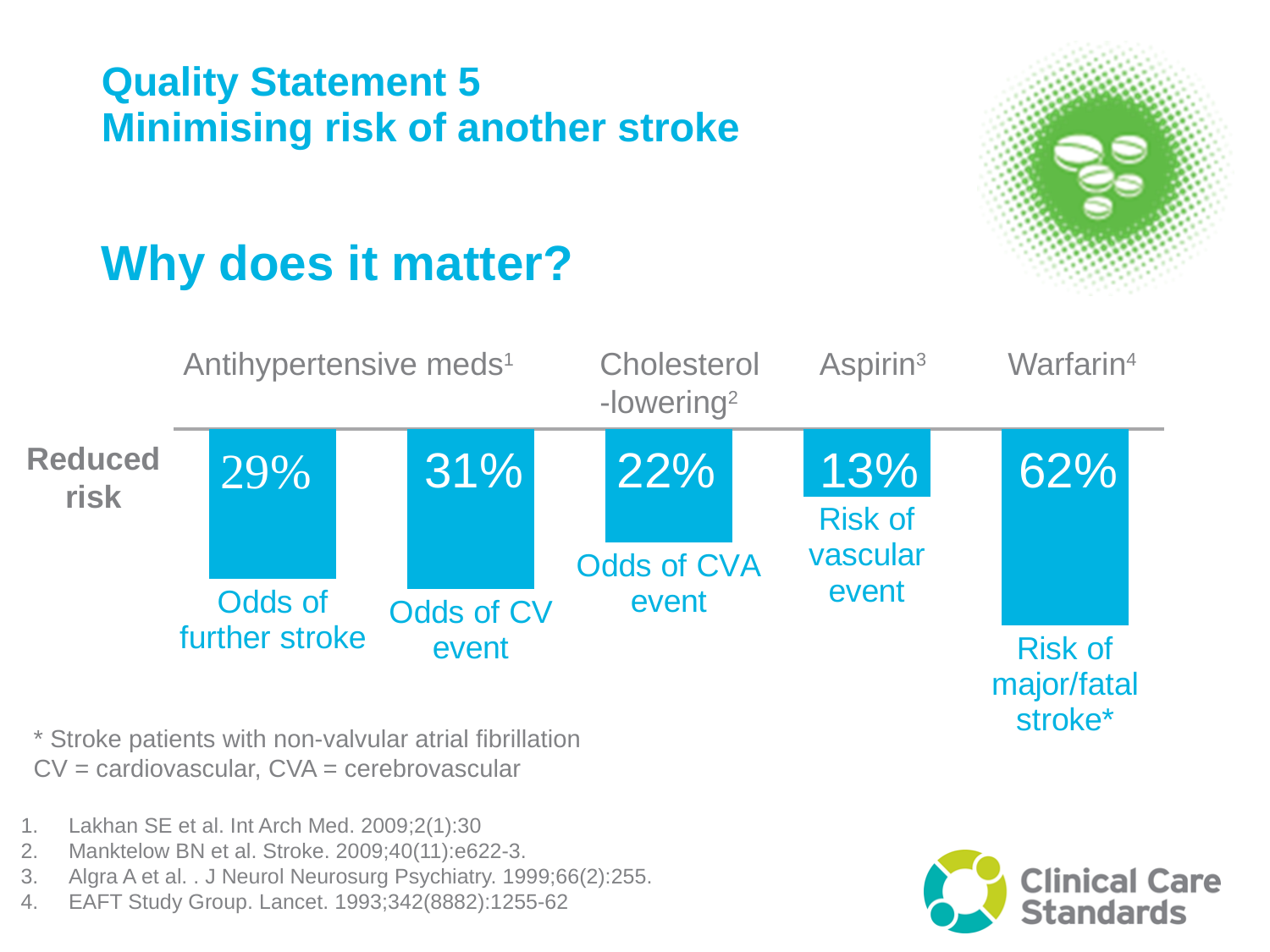
What is the reduced risk value shown for cholesterol-lowering (odds of CVA event)? 22% What is the reduced risk value shown for antihypertensive meds for odds of further stroke? 29% Which is larger: the reduced risk for cholesterol-lowering or the reduced risk for aspirin? Cholesterol-lowering What is the difference between the two antihypertensive meds bars (odds of CV event minus odds of further stroke)? 2% What is the difference between the reduced risk for warfarin and the reduced risk for aspirin? 49% What is the reduced risk value shown for antihypertensive meds for odds of CV event? 31% What kind of chart is shown on the slide? Bar chart What is the reduced risk value shown for warfarin (risk of major/fatal stroke)? 62% How many bars are shown in the chart? 5 Which bar shows the smallest reduced risk? Aspirin (risk of vascular event) What is the reduced risk value shown for aspirin (risk of vascular event)? 13% Which bar shows the largest reduced risk? Warfarin (risk of major/fatal stroke)